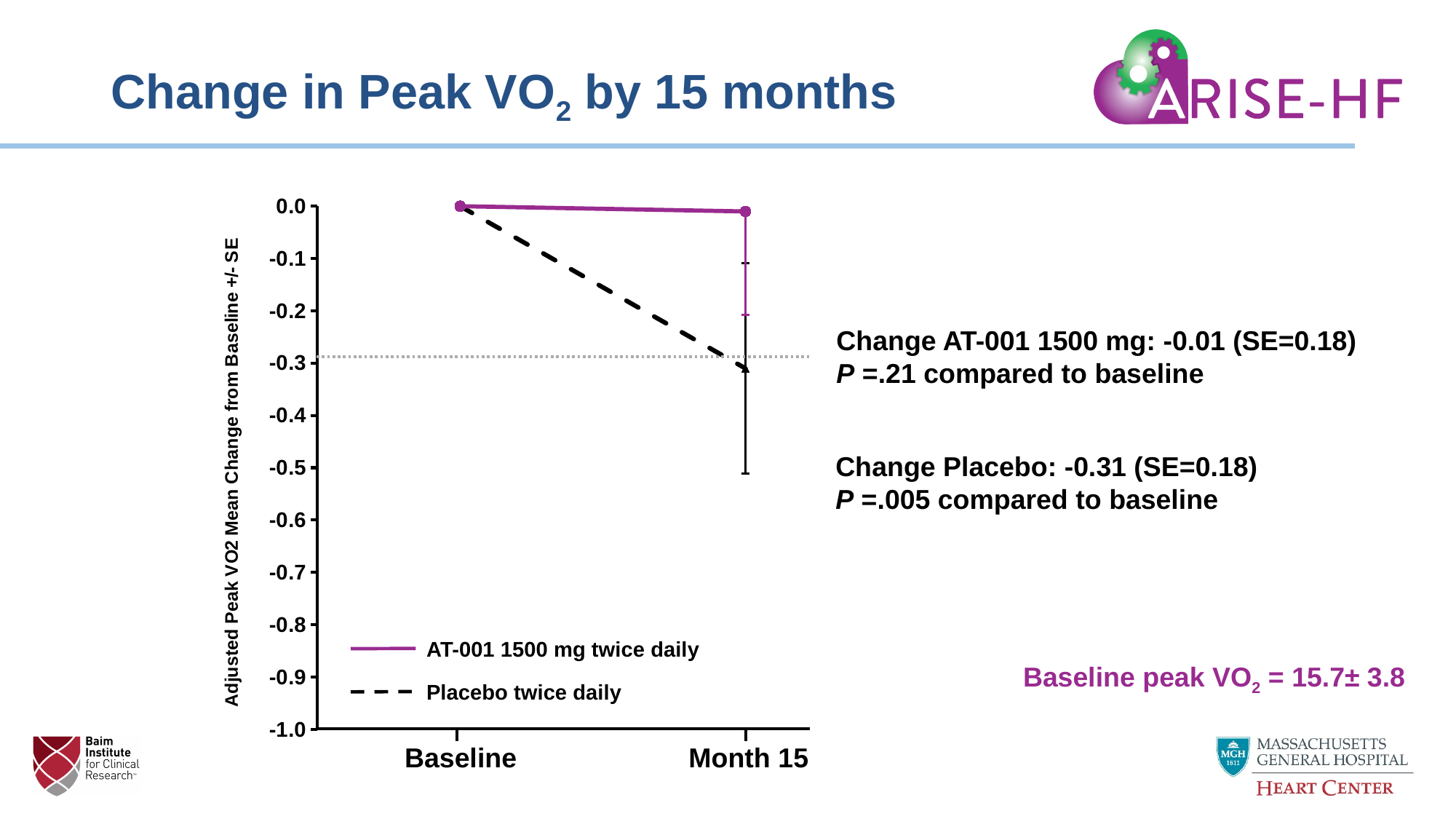
What is the change in peak VO2 at Month 15 for AT-001 1500 mg twice daily? -0.01 How many time points are shown on the x axis? 2 How many series does the legend list? 2 Which series has the higher value at Month 15, AT-001 1500 mg twice daily or Placebo twice daily? AT-001 1500 mg twice daily What is the difference between the AT-001 1500 mg and Placebo changes at Month 15? 0.30 Which series is drawn with a dashed line in the chart? Placebo twice daily What is the change in peak VO2 at Month 15 for Placebo twice daily? -0.31 Is the value for Placebo twice daily at Month 15 greater or less than -0.2? less What is the standard error reported for the Placebo change at Month 15? 0.18 Which series has the lowest value at Month 15? Placebo twice daily What kind of chart is shown on the slide? line chart Does the Placebo twice daily line rise or fall from Baseline to Month 15? fall